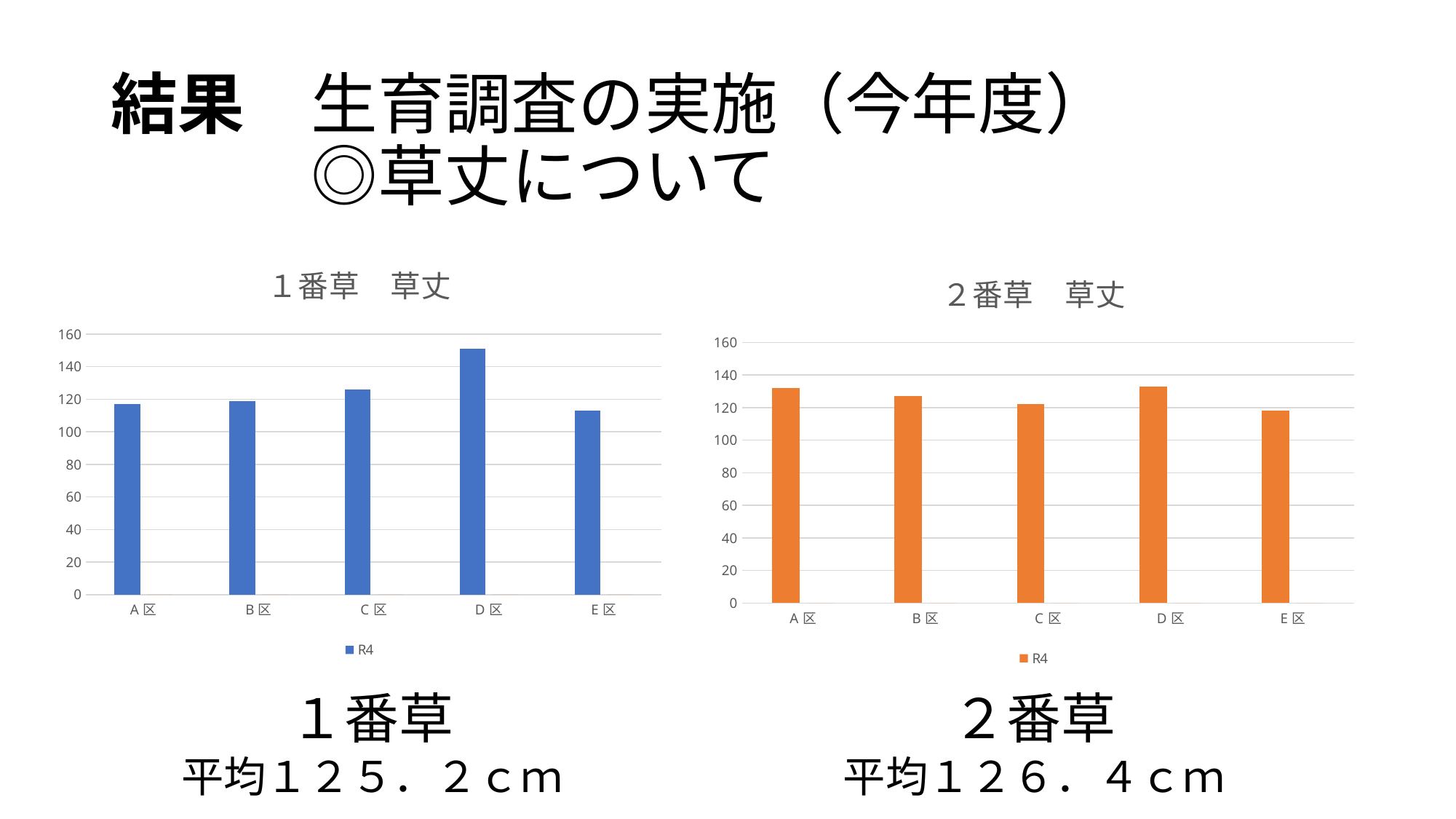
In the "２番草 草丈" chart, is the value for A区 greater or less than 120? greater In the "２番草 草丈" chart, which is larger, the value for A区 or the value for E区? A区 In the "１番草 草丈" chart, is the value for E区 greater or less than 120? less In the "１番草 草丈" chart, which is larger, the value for D区 or the value for A区? D区 In the "１番草 草丈" chart, is the value for D区 greater or less than 140? greater In the "１番草 草丈" chart, how many categories are shown on the x axis? 5 In the "２番草 草丈" chart, how many series does the legend list? 1 What is the legend entry shown in the "１番草 草丈" chart? R4 What is the title of the chart on the right side of the slide? ２番草 草丈 What kind of chart is the "１番草 草丈" chart on the left? bar chart In the "１番草 草丈" chart, which category has the highest bar? D区